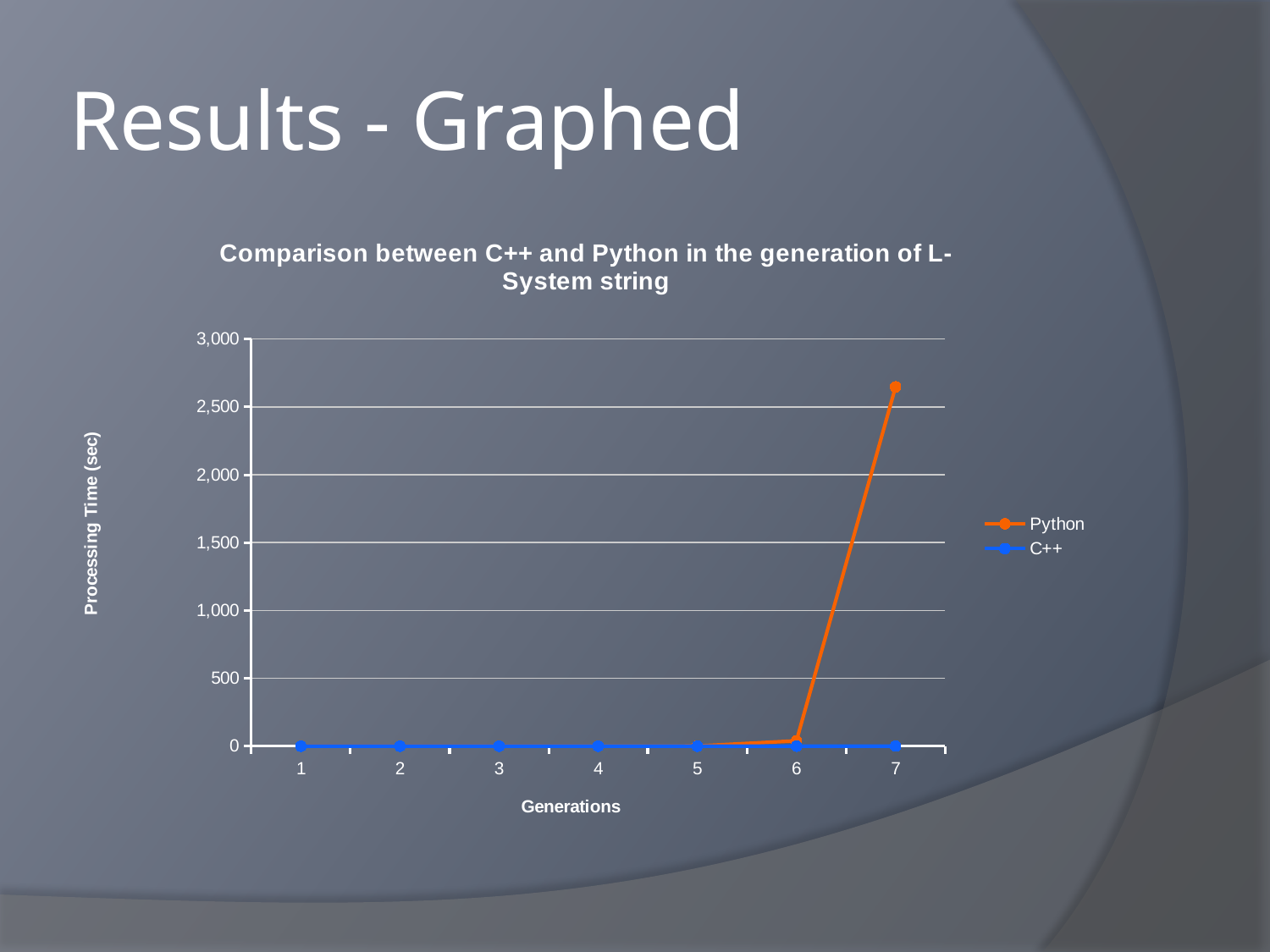
Which series is larger at generation 7, Python or C++? Python Which series has the highest value at generation 7? Python How many series does the legend list? 2 What kind of chart is shown on the slide? line chart What is the label of the y axis? Processing Time (sec) Does the Python series rise or fall from generation 6 to generation 7? rise Is the C++ value at generation 7 greater or less than 500? less Is the Python value at generation 7 greater or less than 2,500? greater How many generations are plotted along the x axis? 7 Is the Python value at generation 7 greater or less than 3,000? less What colour is the Python line? orange